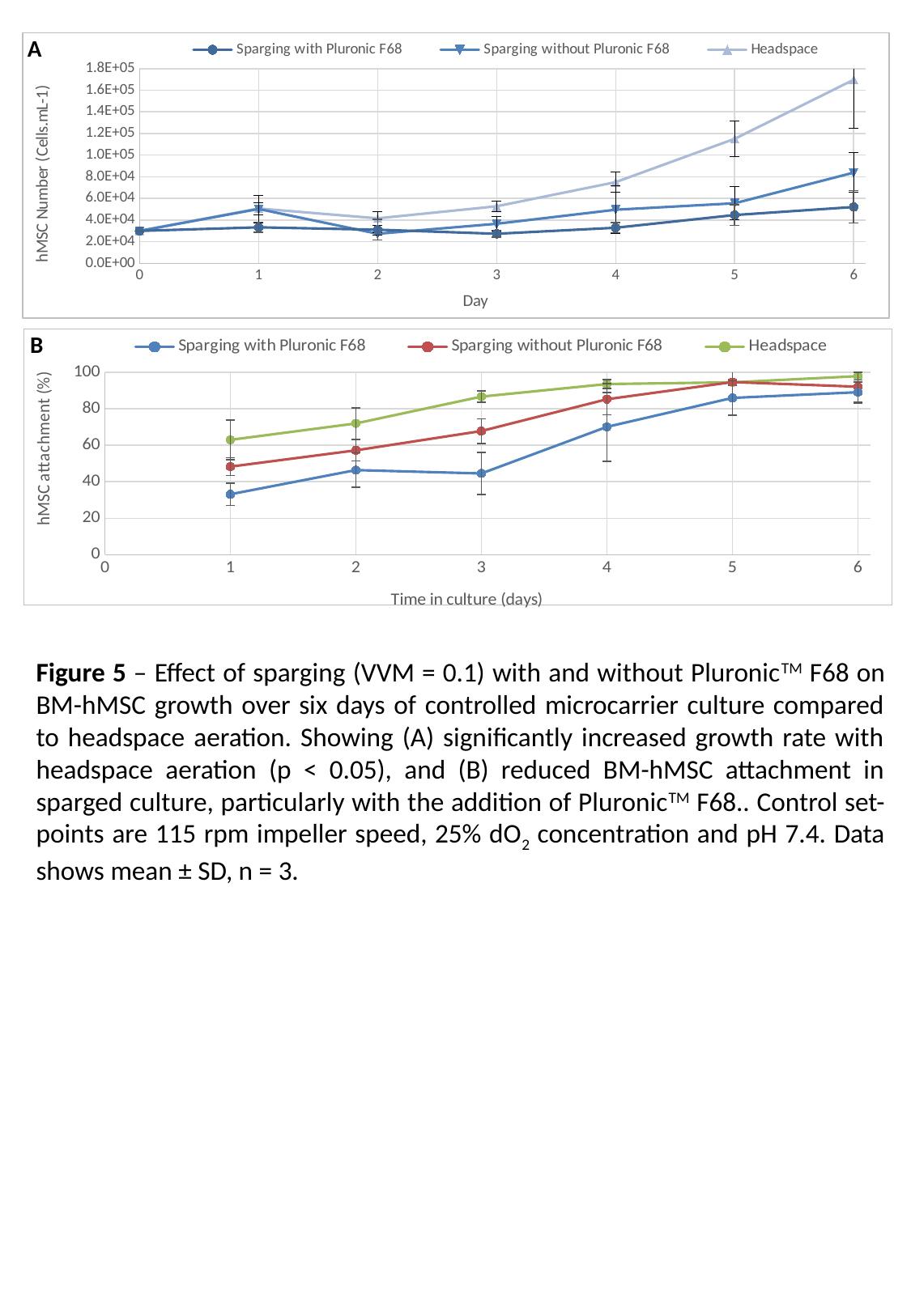
In chart B, is the value for Sparging with Pluronic F68 at day 1 greater or less than 40? less How many data points does each series in chart B have? 6 In chart A, is the Headspace value at day 6 greater or less than 1.4E+05? greater In chart B, does the Headspace series generally rise or fall over time in culture? rise In chart A, which series has the highest hMSC number at day 6? Headspace In chart A, which is larger at day 5: Headspace or Sparging without Pluronic F68? Headspace In chart A, is the value for Sparging with Pluronic F68 at day 6 greater or less than 6.0E+04? less In chart B, which series has the lowest hMSC attachment at day 1? Sparging with Pluronic F68 What kind of chart is chart A? line chart How many series does the legend of chart B list? 3 What is the y-axis label of chart B? hMSC attachment (%)